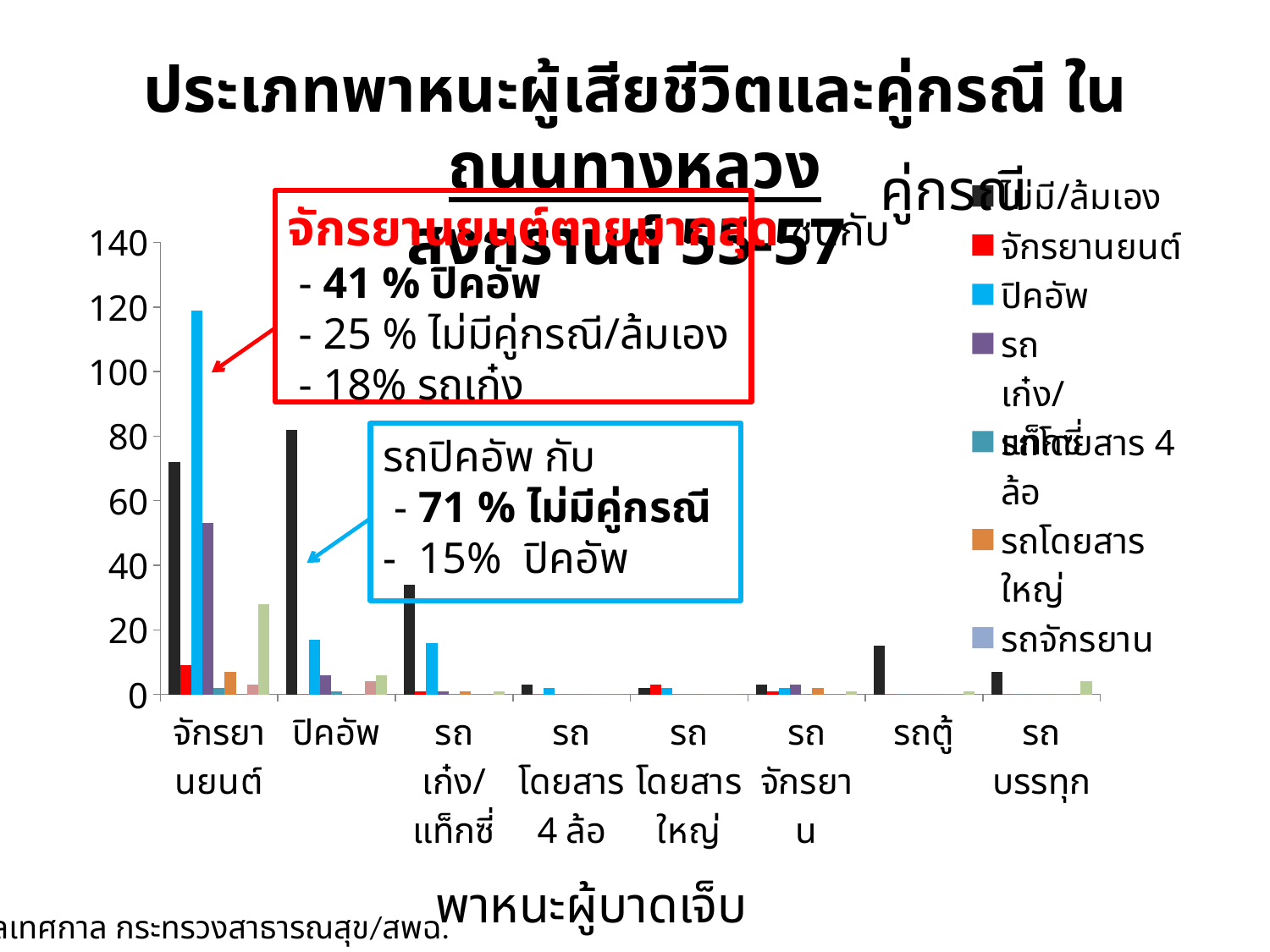
What kind of chart is shown on the slide? bar chart How many vehicle categories are shown on the x axis? 8 Is the value of the ปิคอัพ series for the จักรยานยนต์ category greater or less than 100? greater Is the value of the ไม่มี/ล้มเอง series for the จักรยานยนต์ category greater or less than 60? greater Which is larger: the ปิคอัพ series value for the จักรยานยนต์ category or the ปิคอัพ series value for the ปิคอัพ category? จักรยานยนต์ Is the value of the ไม่มี/ล้มเอง series for the ปิคอัพ category greater or less than 100? less What is the title of the x axis? พาหนะผู้บาดเจ็บ Which category contains the tallest bar in the whole chart? จักรยานยนต์ Which series has the tallest bar in the จักรยานยนต์ category? ปิคอัพ Which series has the tallest bar in the ปิคอัพ category? ไม่มี/ล้มเอง